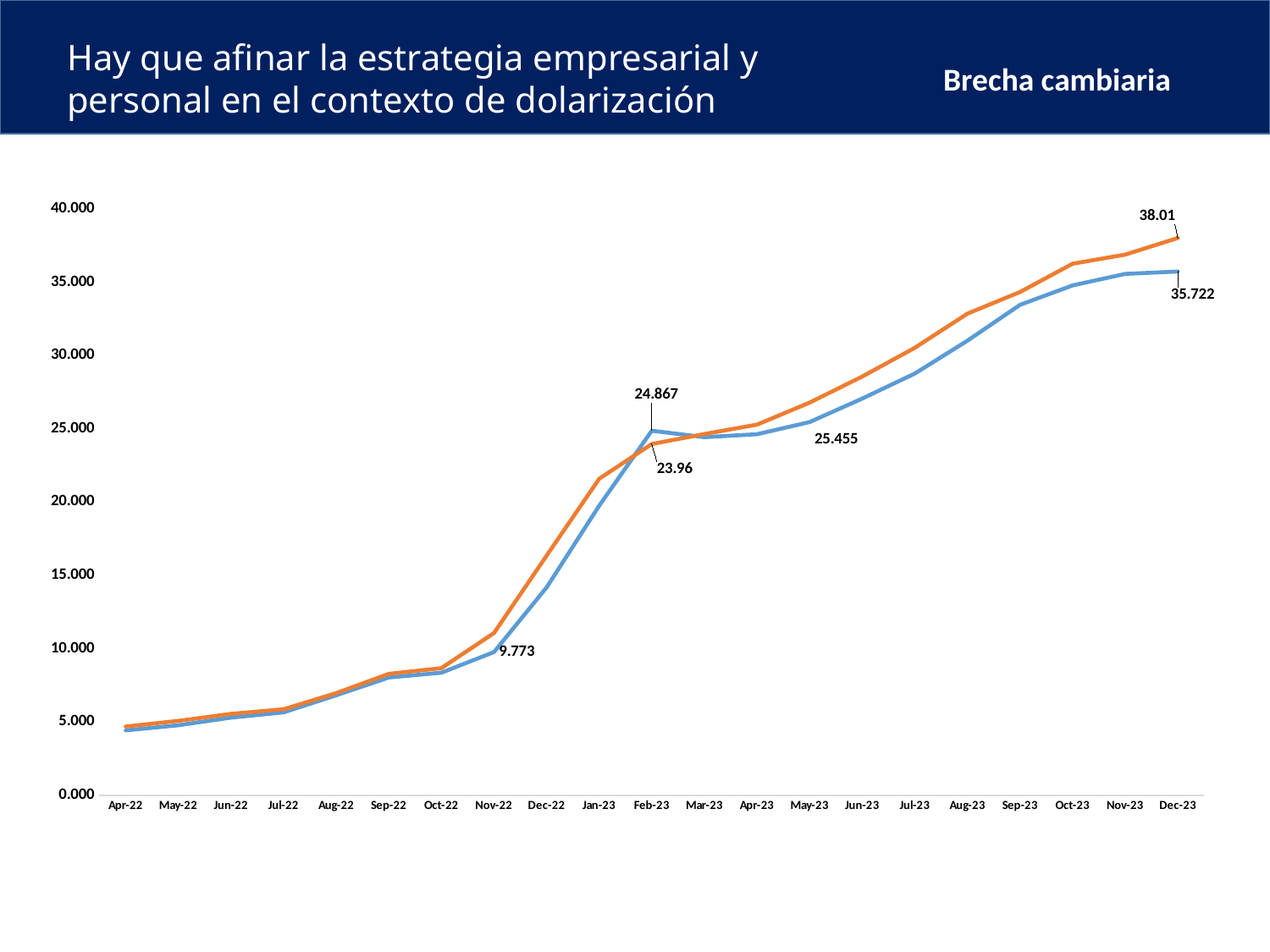
Do the values of the lines generally rise or fall from Apr-22 to Dec-23? Rise What is the labelled value of the orange line at Feb-23? 23.96 What is the labelled value of the blue line at Dec-23? 35.722 What is the labelled value of the blue line at May-23? 25.455 What is the title of the chart shown on the slide? Brecha cambiaria How many months are shown along the x axis of the chart? 21 What is the labelled value of the orange line at Dec-23? 38.01 What is the labelled value of the blue line at Feb-23? 24.867 What is the labelled value of the blue line at Nov-22? 9.773 At Dec-23, which line has the higher value, the orange line or the blue line? Orange line What kind of chart is shown on the slide? Line chart Is the value of the orange line at Aug-23 greater or less than 30.000? greater